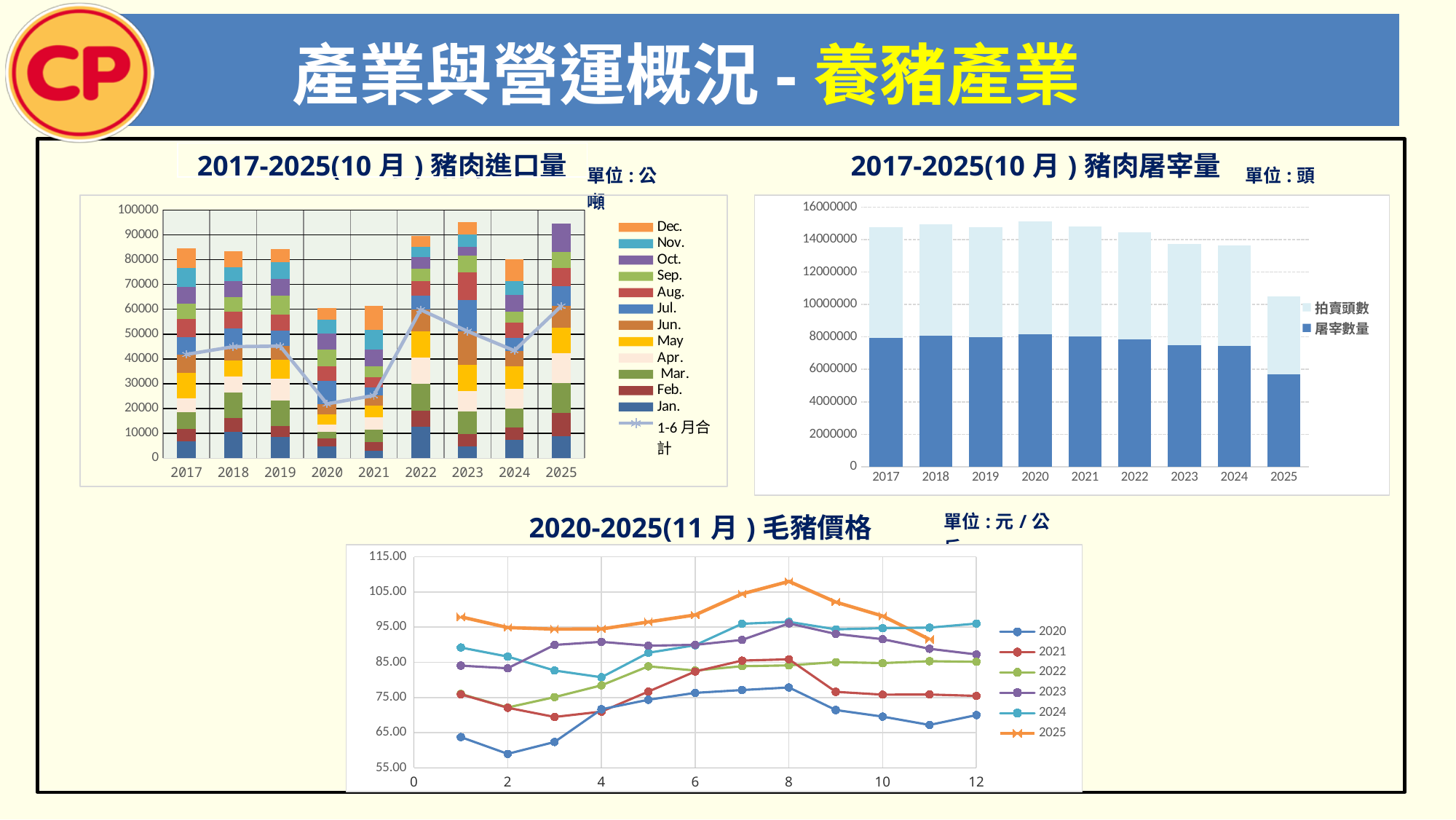
In the 2020-2025(11月) 毛豬價格 chart, is the 2025 value at month 8 greater or less than 105.00? greater In the 2017-2025(10月) 豬肉屠宰量 chart, which year has the lowest total? 2025 In the 2017-2025(10月) 豬肉屠宰量 chart, is the total for 2025 greater or less than 12000000? less In the 2017-2025(10月) 豬肉進口量 chart, is the total stacked value for 2020 greater or less than 70000? less In the 2017-2025(10月) 豬肉屠宰量 chart, which year has the larger total, 2020 or 2023? 2020 In the 2017-2025(10月) 豬肉進口量 chart, how many entries does the legend list? 13 What type of chart is the 2017-2025(10月) 豬肉進口量 chart? stacked bar chart with a line In the 2017-2025(10月) 豬肉進口量 chart, how many years are shown on the x axis? 9 In the 2020-2025(11月) 毛豬價格 chart, how many series does the legend list? 6 In the 2020-2025(11月) 毛豬價格 chart, which series has the lowest value at month 2? 2020 In the 2017-2025(10月) 豬肉屠宰量 chart, how many series does the legend list? 2